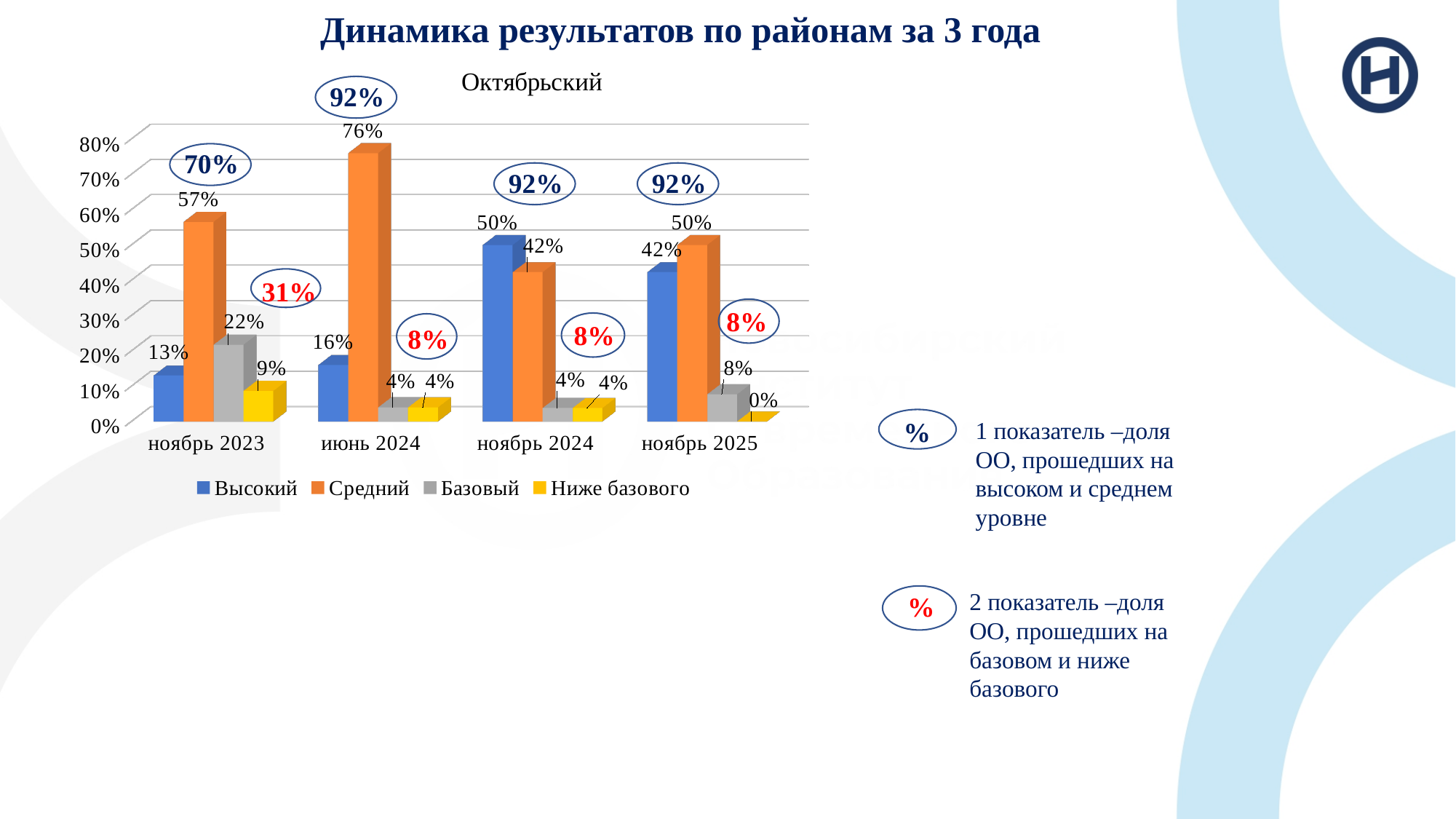
In which period is the Высокий series lowest? ноябрь 2023 What is the title of the chart? Октябрьский Which is larger in ноябрь 2024: Высокий or Средний? Высокий How many series does the legend list? 4 What is the value for Базовый in июнь 2024? 4% How many periods are shown on the x axis? 4 What kind of chart is shown? bar chart What is the difference between Средний and Высокий in ноябрь 2025? 8% What is the value for Высокий in ноябрь 2024? 50% What is the value for Ниже базового in ноябрь 2025? 0% What is the value for Средний in ноябрь 2023? 57% In which period is the Средний series highest? июнь 2024